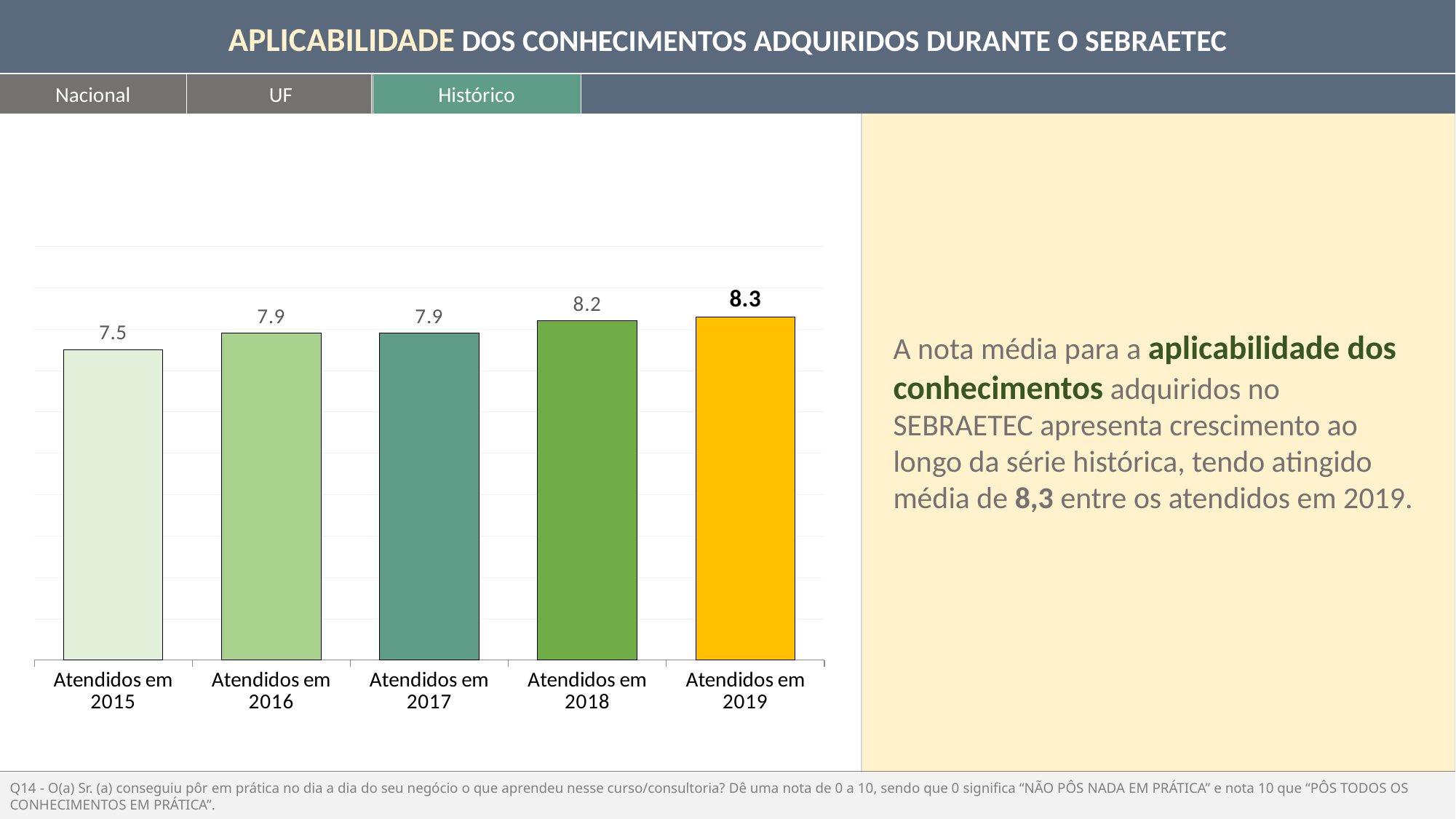
Which category has the lowest value? Atendidos em 2015 Do the values generally rise or fall from 2015 to 2019? rise What is the difference between the values for Atendidos em 2019 and Atendidos em 2015? 0.8 What is the value for Atendidos em 2019? 8.3 Which is larger, the value for Atendidos em 2018 or the value for Atendidos em 2016? Atendidos em 2018 Which category has the highest value? Atendidos em 2019 What is the difference between the values for Atendidos em 2018 and Atendidos em 2016? 0.3 How many categories are shown in the chart? 5 What kind of chart is shown on the slide? bar chart What is the value for Atendidos em 2015? 7.5 Which bar in the chart is coloured yellow/orange? Atendidos em 2019 What is the value for Atendidos em 2018? 8.2